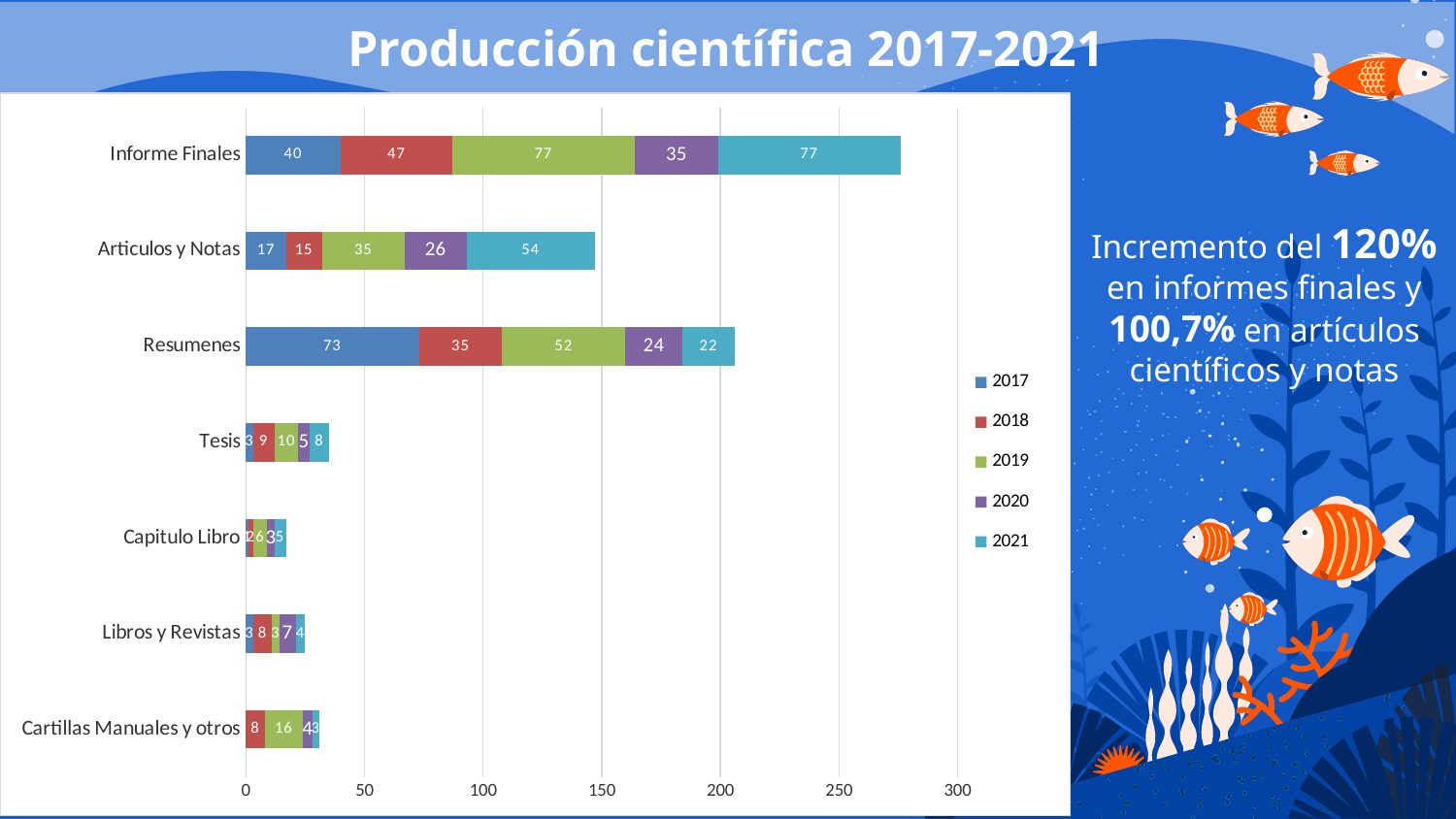
Which category has the longest total bar? Informe Finales Is the total bar for Resumenes greater or less than 200? greater How many categories are plotted on the vertical axis? 7 Which year does the green segment represent according to the legend? 2019 What kind of chart is shown on the slide? Stacked bar chart What is the total of the stacked bar for Informe Finales? 276 What is the 2021 value for Articulos y Notas? 54 How many series does the legend list? 5 What is the difference between the 2018 and 2017 values for Informe Finales? 7 What is the 2019 value for Informe Finales? 77 What is the 2017 value for Resumenes? 73 Which is larger: the 2017 value for Resumenes or the 2017 value for Informe Finales? Resumenes